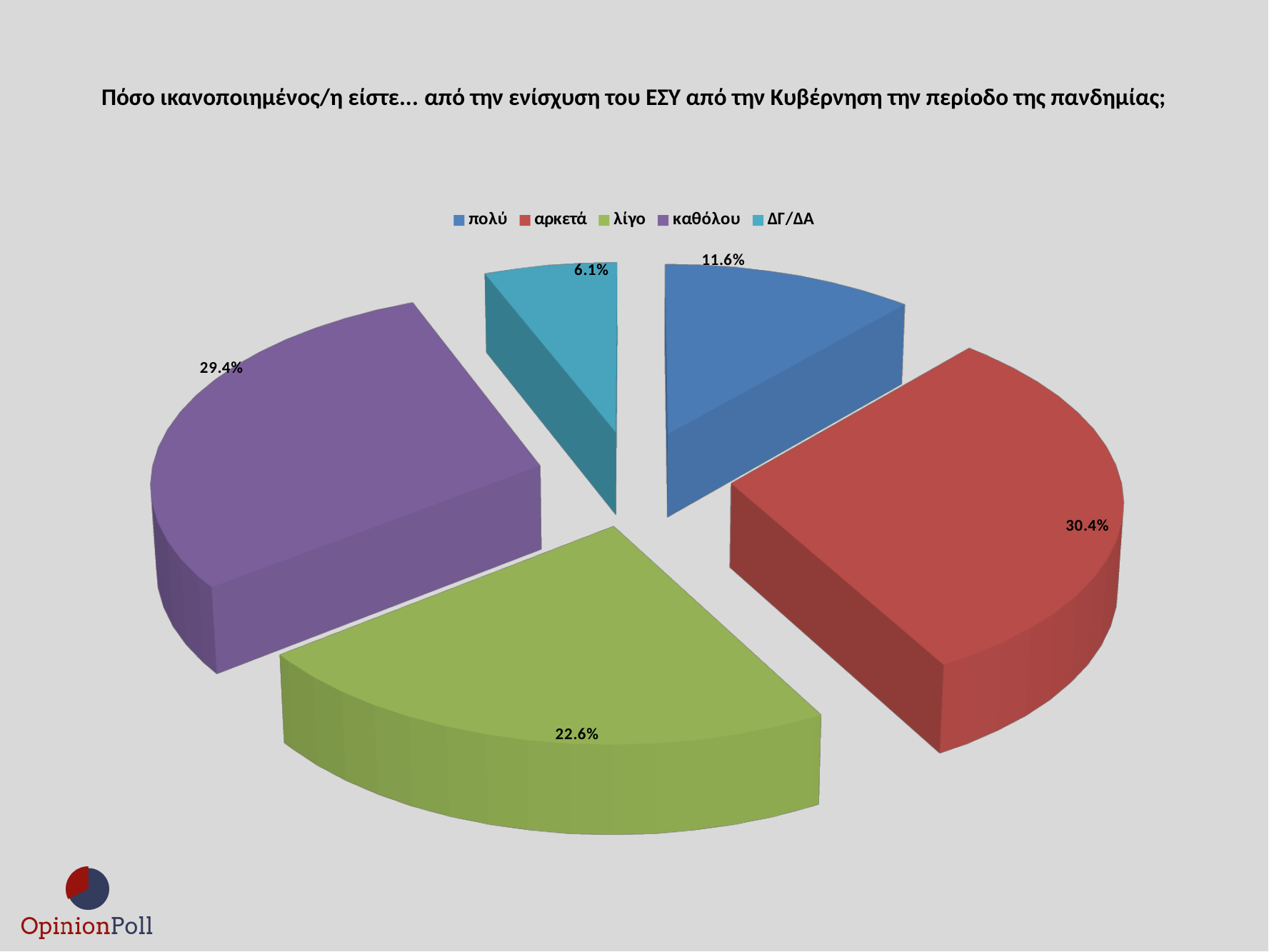
What percentage is shown for the "καθόλου" slice? 29.4% How many slices does the pie chart have? 5 Which is larger, the "λίγο" slice or the "πολύ" slice? λίγο Which category has the smallest share of the pie? ΔΓ/ΔΑ Which category has the largest share of the pie? αρκετά What percentage is shown for the "πολύ" slice? 11.6% What percentage is shown for the "λίγο" slice? 22.6% What percentage is shown for the "ΔΓ/ΔΑ" slice? 6.1% What percentage is shown for the "αρκετά" slice? 30.4% What colour is the "καθόλου" slice? purple What kind of chart is shown on the slide? pie chart How many percentage points larger is "καθόλου" than "λίγο"? 6.8